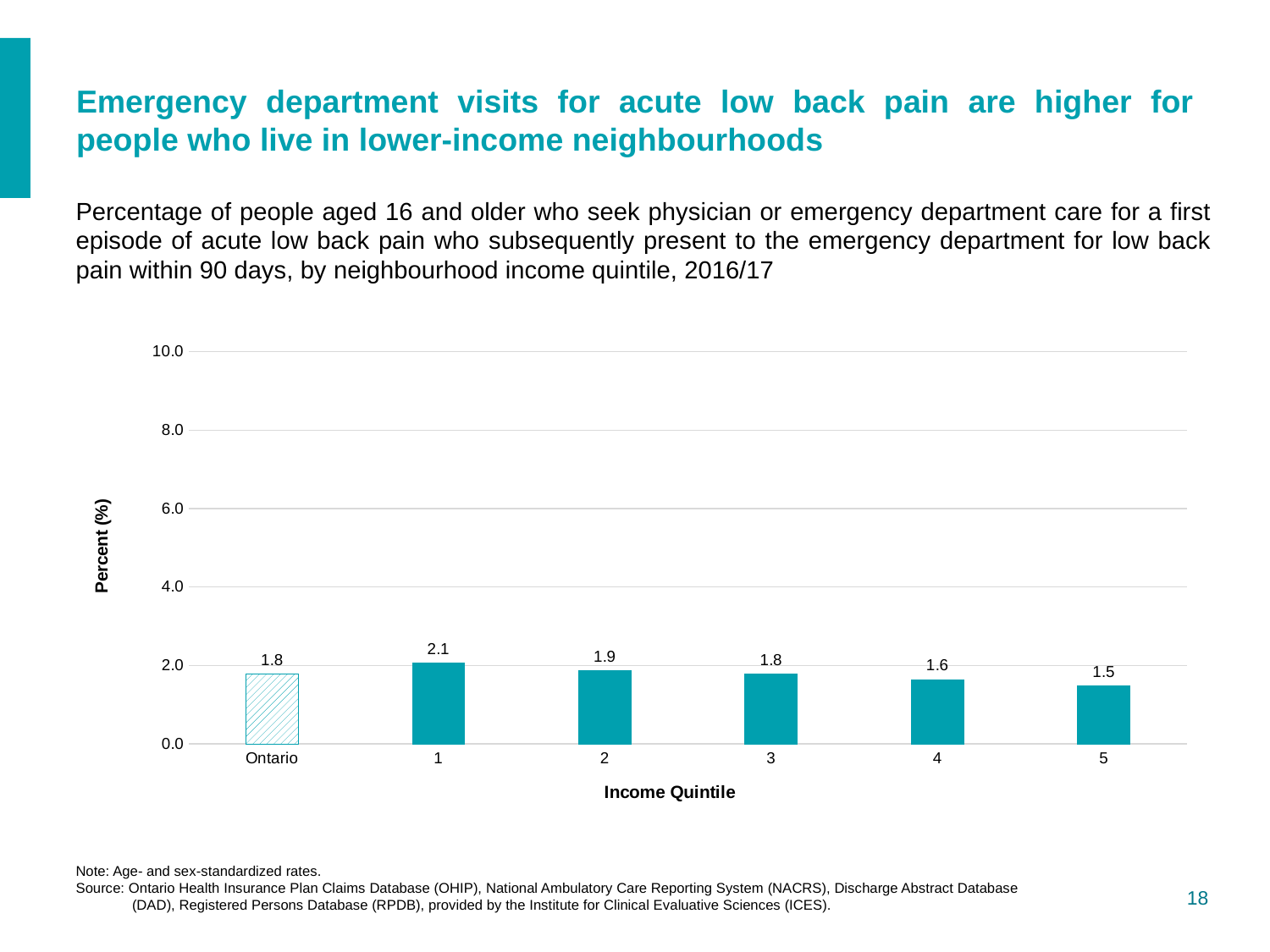
What kind of chart is shown? Bar chart What is the value for Ontario? 1.8 Do the values rise or fall from income quintile 1 to income quintile 5? Fall What is the difference between the values for income quintile 1 and income quintile 5? 0.6 What is the value for income quintile 5? 1.5 Which is larger, the value for income quintile 2 or income quintile 4? Income quintile 2 What is the value for income quintile 1? 2.1 Is the value for income quintile 1 greater or less than 2.0? greater What is the label of the y axis? Percent (%) How many categories are shown on the x axis? 6 Which income quintile has the highest value? 1 Which income quintile has the lowest value? 5